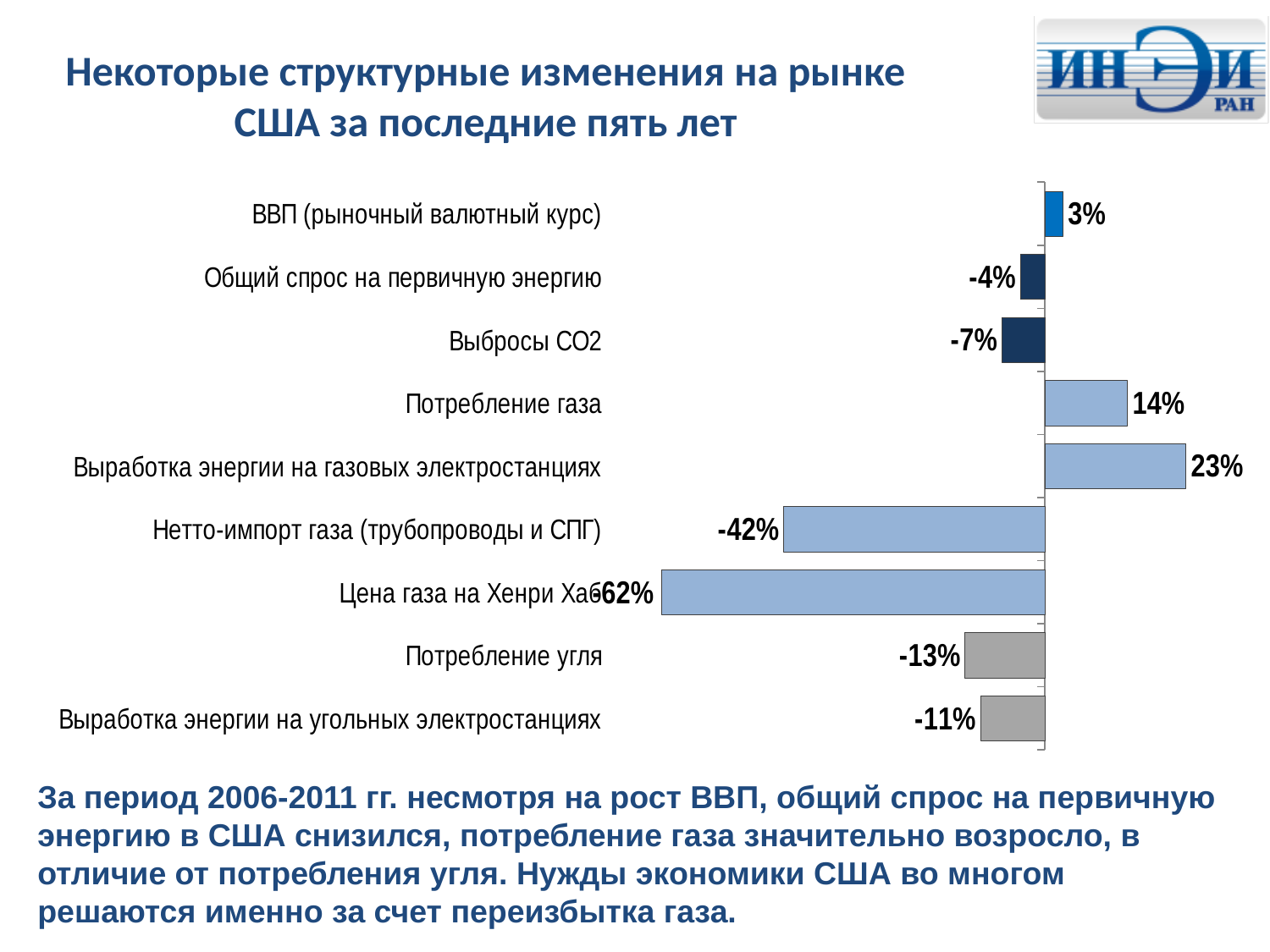
What is the value shown for ВВП (рыночный валютный курс)? 3% What is the value shown for Потребление угля? -13% What is the value shown for Нетто-импорт газа (трубопроводы и СПГ)? -42% What is the difference between the values for Выработка энергии на газовых электростанциях and Потребление газа? 9 percentage points Which category has the lowest value? Цена газа на Хенри Хаб What is the value shown for Выбросы CO2? -7% What is the value shown for Выработка энергии на газовых электростанциях? 23% How many categories are shown in the chart? 9 Which category has the highest value? Выработка энергии на газовых электростанциях What is the value shown for Потребление газа? 14% Which is larger: the value for Потребление угля or the value for Выработка энергии на угольных электростанциях? Выработка энергии на угольных электростанциях What type of chart is shown on the slide? Bar chart